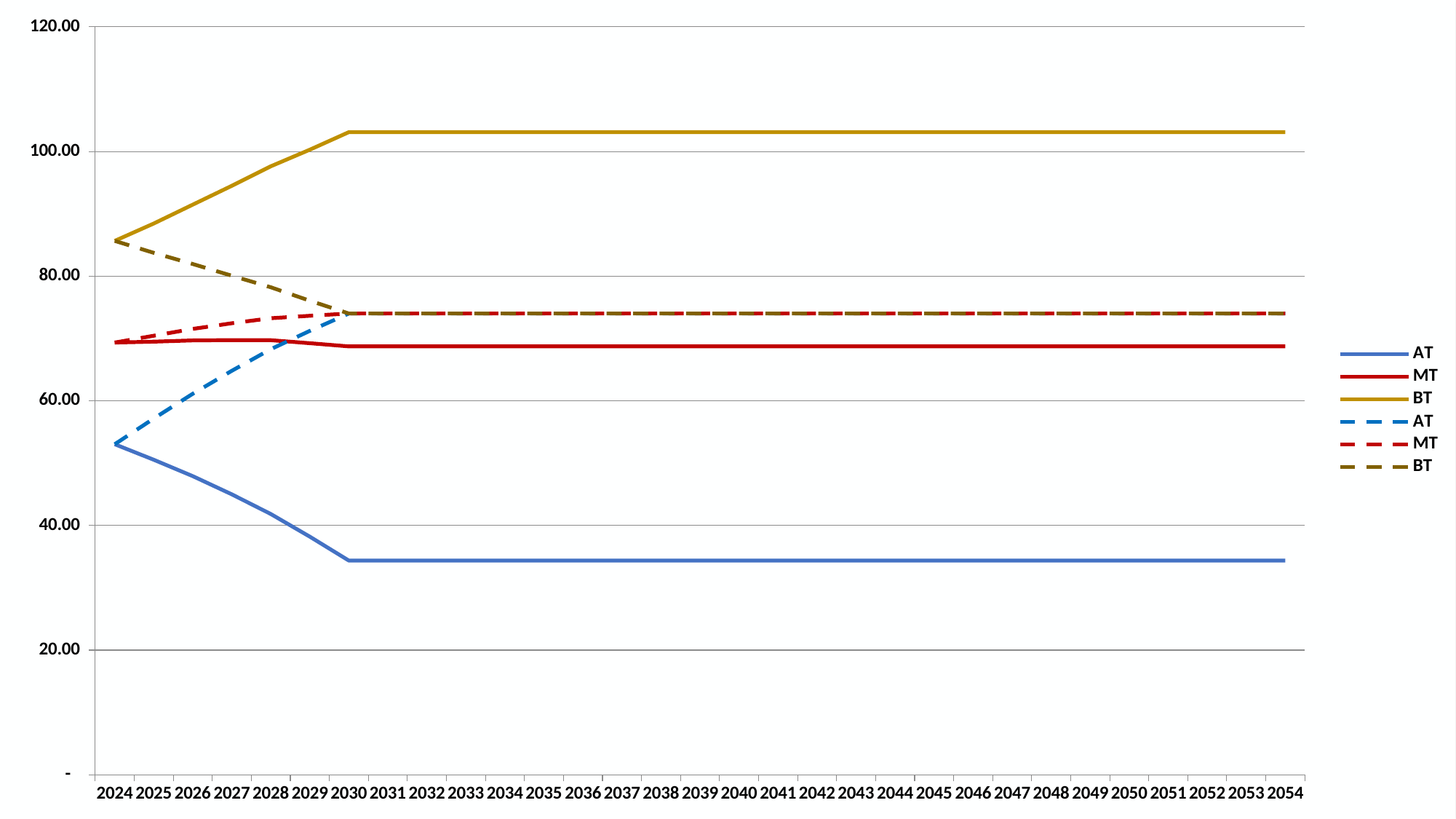
Does the dashed BT line rise or fall between 2024 and 2030? fall Is the value of the solid AT line in 2054 greater or less than 40? less Is the value of the solid BT line in 2054 greater or less than 100? greater Which solid line has the highest value in 2054? BT Does the solid BT line rise or fall between 2024 and 2030? rise Which solid line has the lowest value in 2054? AT What kind of chart is shown on the slide? line chart Which series names appear in the legend? AT, MT, BT Does the solid AT line rise or fall between 2024 and 2030? fall How many series does the legend list? 6 How many years are shown along the x axis? 31 What is the first year shown on the x axis? 2024